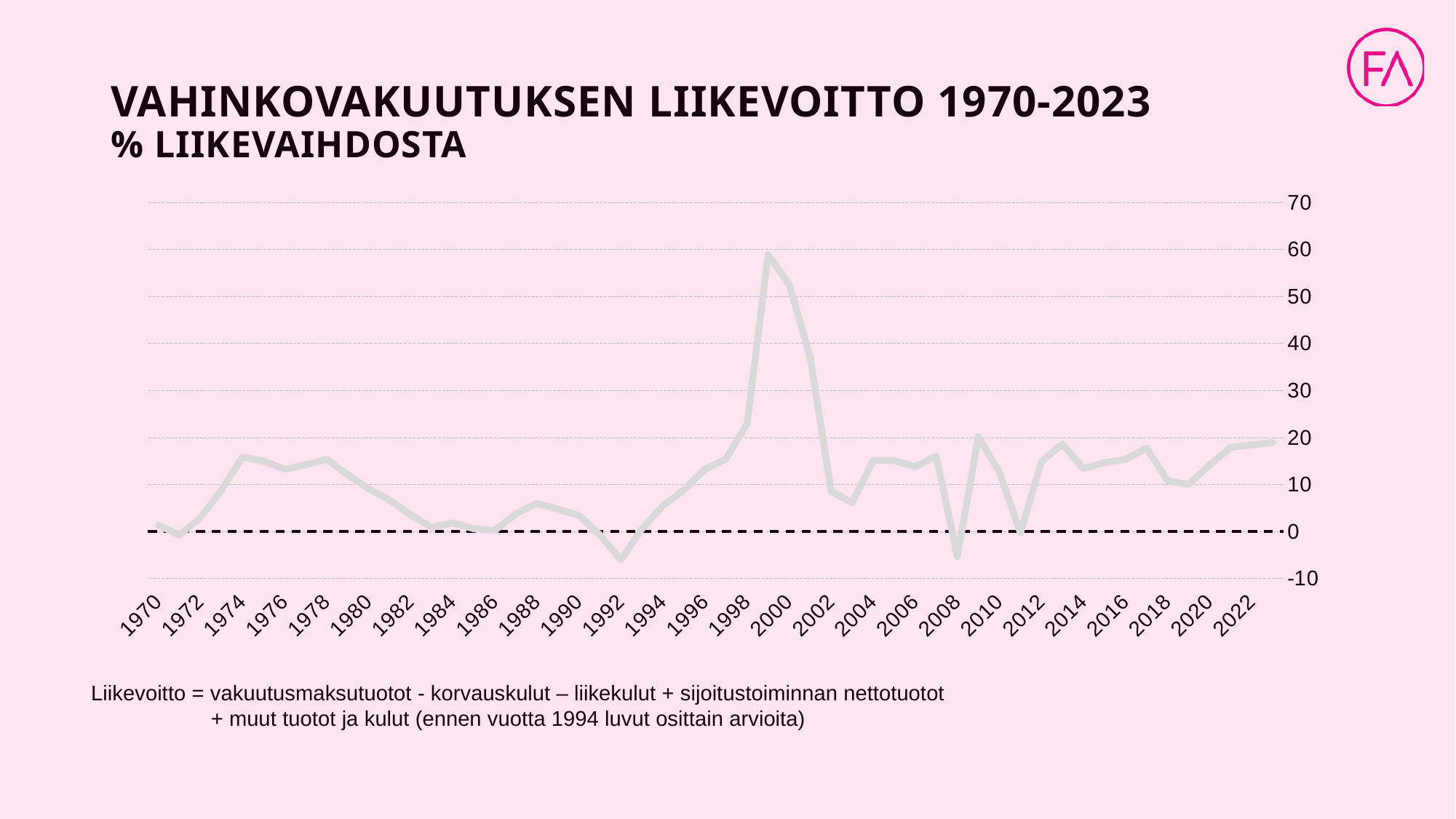
Is the value for 1999 greater or less than 50? greater Is the value for 2008 greater or less than 0? less In which year does the line reach its highest value? 1999 What is the title of the chart? VAHINKOVAKUUTUKSEN LIIKEVOITTO 1970-2023 % LIIKEVAIHDOSTA Which year has the larger value, 2008 or 2009? 2009 Is the value for 1985 greater or less than 10? less What kind of chart is shown on the slide? line chart What is the highest value shown on the y axis? 70 Which year has the larger value, 1999 or 2023? 1999 Does the line rise or fall between 1999 and 2002? fall